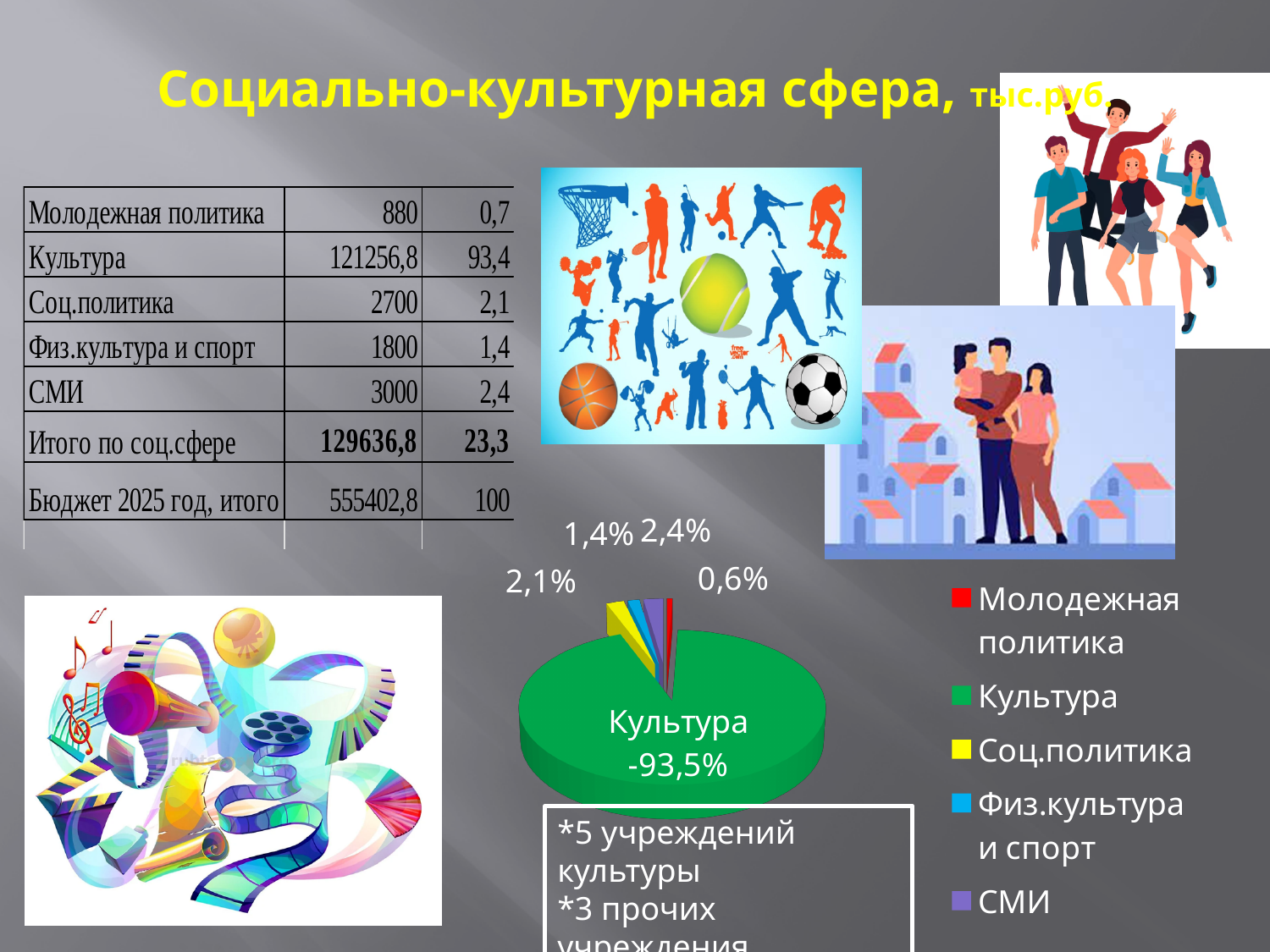
What kind of chart is shown on the slide? pie chart How many categories does the pie chart's legend list? 5 Which colour represents Культура in the pie chart legend? green Which is larger in the pie chart, the slice for Культура or the slice for Соц.политика? Культура Which category has the largest slice in the pie chart? Культура What share of the pie chart is labelled for Культура? 93,5% Is the share for Культура in the pie chart greater or less than 50%? greater Which category is shown in red in the pie chart legend? Молодежная политика Which is larger in the pie chart, the slice for Культура or the slice for СМИ? Культура